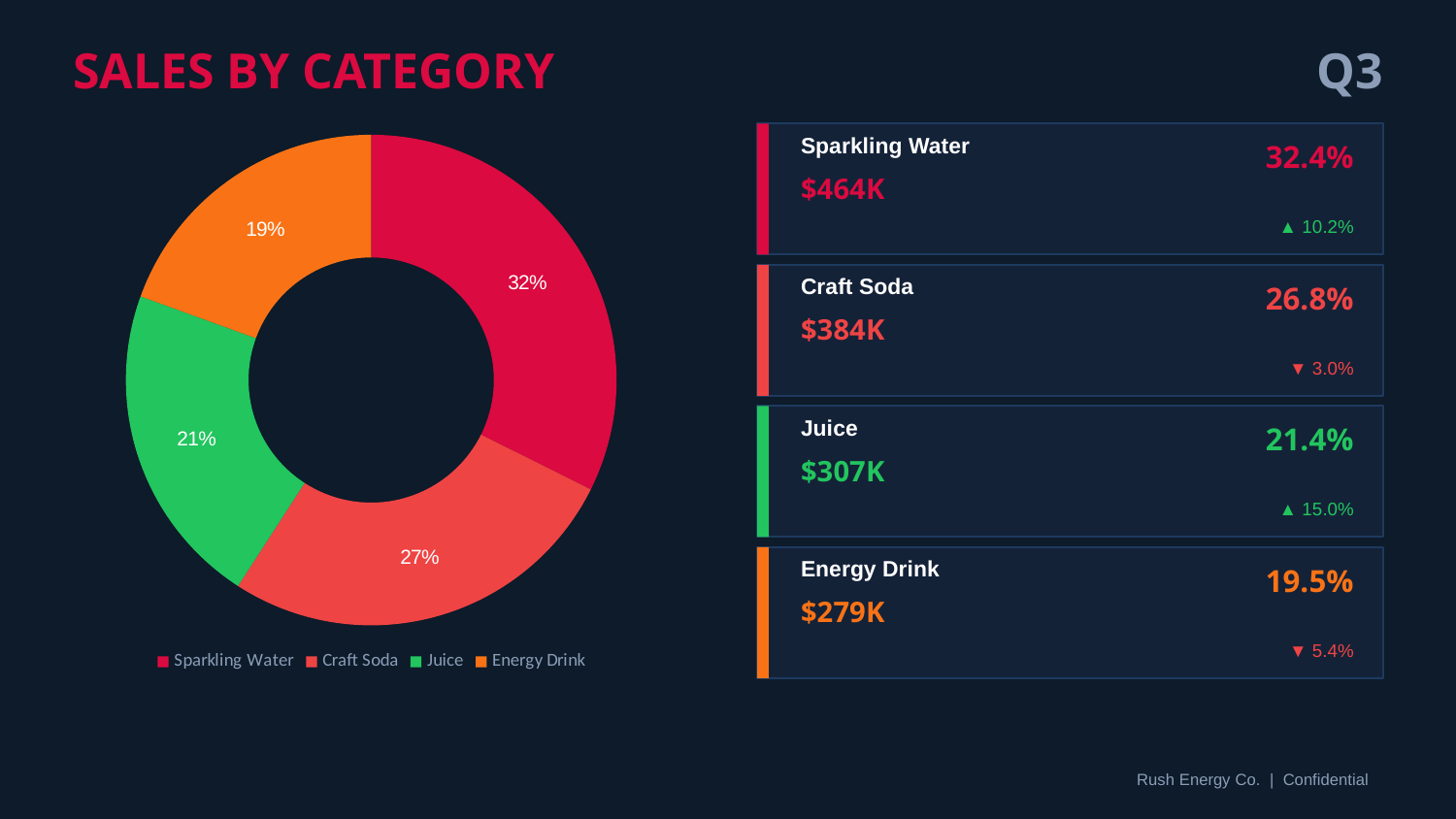
Which category has the largest slice of the pie? Sparkling Water What kind of chart is shown on the slide? Pie chart (donut) What share of the pie does Juice have? 21% What share of the pie does Sparkling Water have? 32% What is the difference in percentage points between the Sparkling Water slice and the Energy Drink slice? 13 percentage points How many categories are shown in the pie chart? 4 Which slice is larger, Craft Soda or Juice? Craft Soda Which category has the smallest slice of the pie? Energy Drink What share of the pie does Energy Drink have? 19% What is the title of the chart on the slide? SALES BY CATEGORY Which colour represents Juice in the pie chart? Green